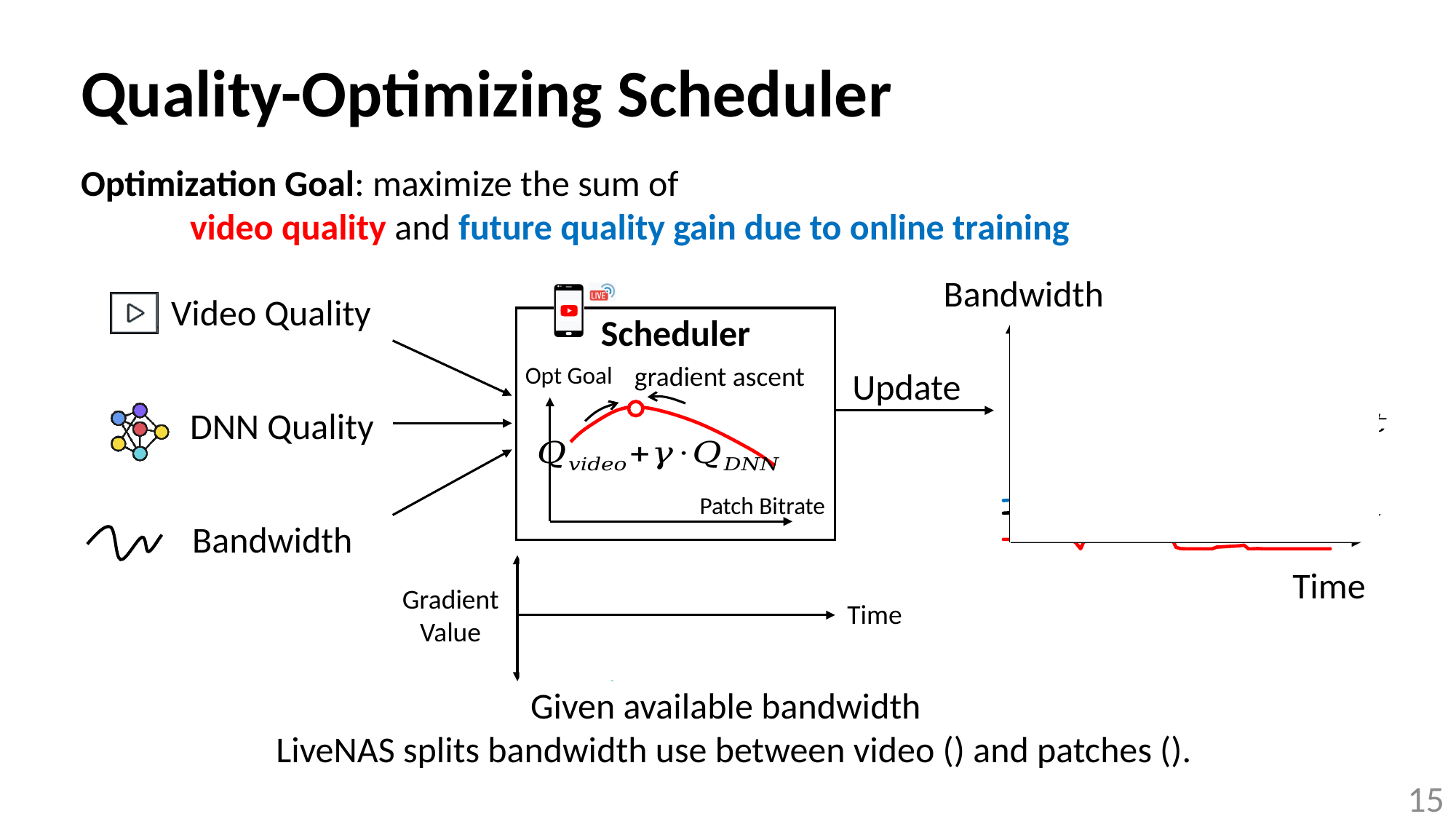
What is the label on the horizontal axis of the chart inside the Scheduler box? Patch Bitrate In the chart inside the Scheduler box, does the red Opt Goal curve rise, fall, or rise then fall as Patch Bitrate increases? rise then fall What kind of chart is the Bandwidth chart on the right side of the slide? line chart What is the label on the vertical axis of the chart on the right side of the slide? Bandwidth